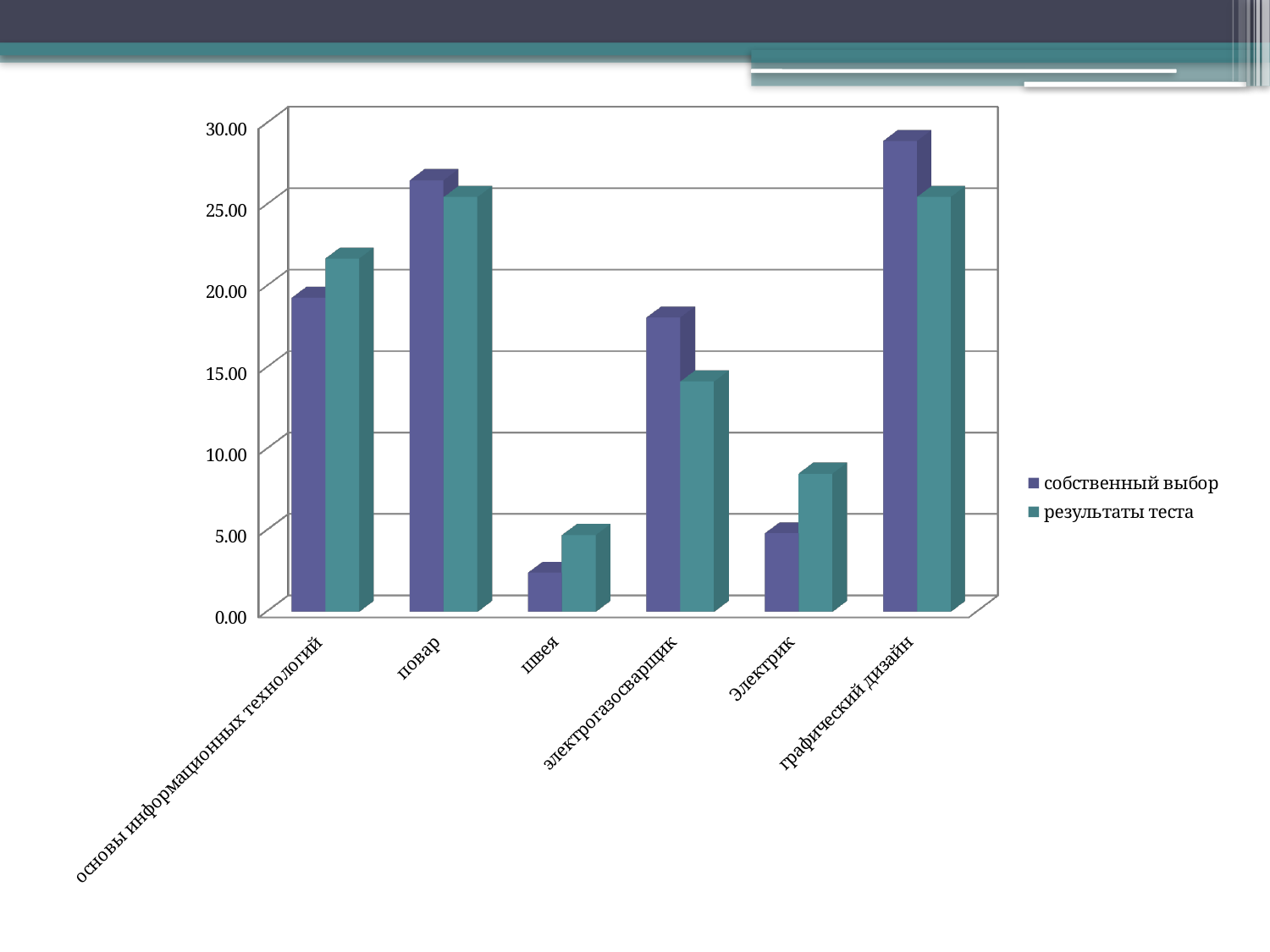
Which category has the lowest value for the series результаты теста? швея For электрогазосварщик, which series has the larger value: собственный выбор or результаты теста? собственный выбор Which category has the lowest value for the series собственный выбор? швея How many series does the chart's legend list? 2 Which category has the highest value for the series собственный выбор? графический дизайн What kind of chart is shown on the slide? bar chart How many categories are shown on the x axis of the chart? 6 Is the value of результаты теста for Электрик greater or less than 10.00? less Which two series are listed in the chart's legend? собственный выбор and результаты теста Is the value of собственный выбор for электрогазосварщик greater or less than 15.00? greater For Электрик, which series has the larger value: собственный выбор or результаты теста? результаты теста Is the value of результаты теста for основы информационных технологий greater or less than 20.00? greater